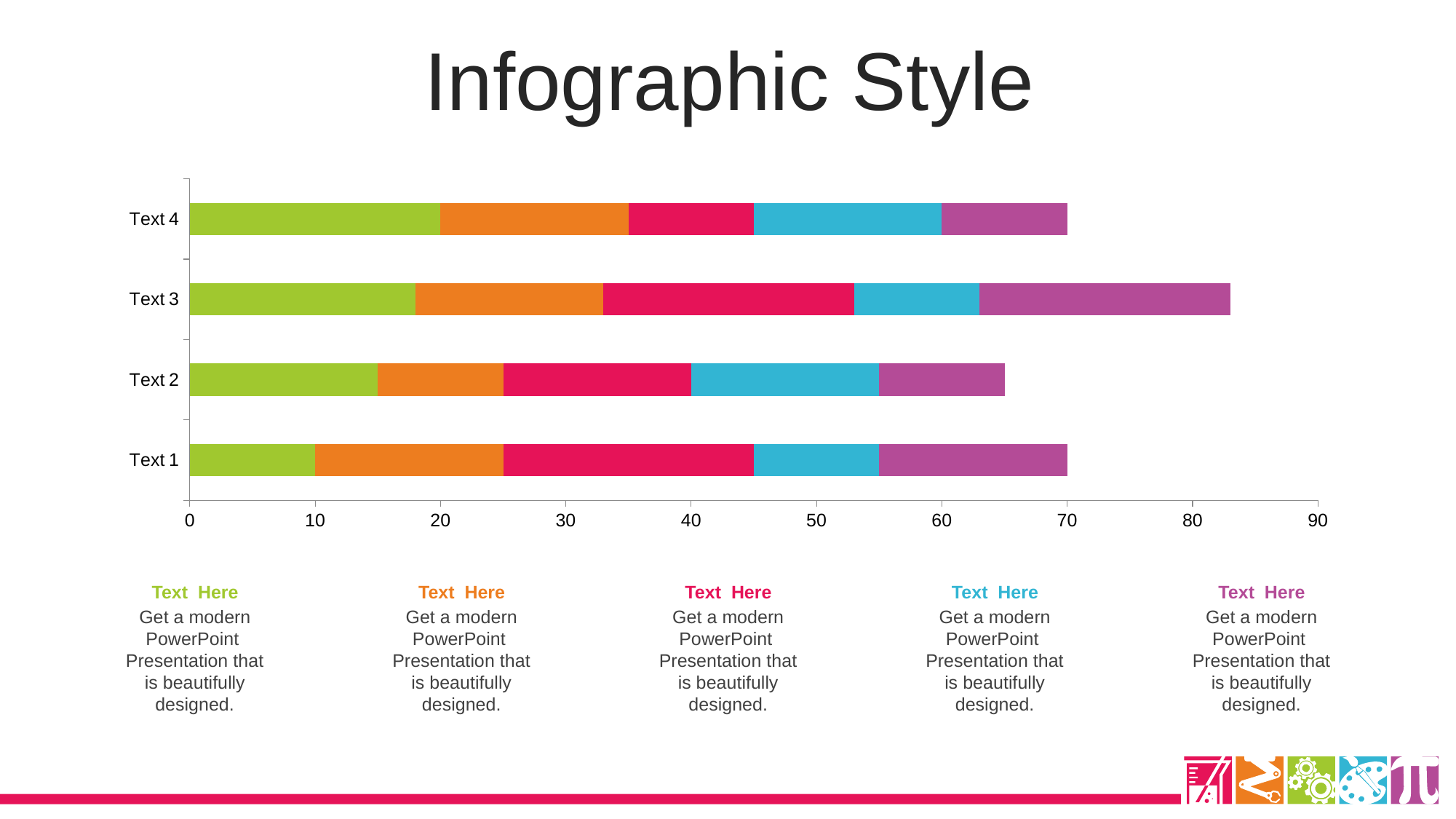
What is the total length of the bar for Text 1? 70 Is the total for Text 2 greater or less than 70? less What is the title of the slide containing the chart? Infographic Style Which category has the shortest bar overall? Text 2 Which category has the longest bar overall? Text 3 Is the total for Text 3 greater or less than 80? greater What kind of chart is shown on the slide? Stacked bar chart How many categories are plotted on the chart? 4 What is the value of the green segment for Text 4? 20 How many coloured segments make up each bar in the chart? 5 What is the total length of the bar for Text 4? 70 Which bar is longer overall, Text 3 or Text 4? Text 3